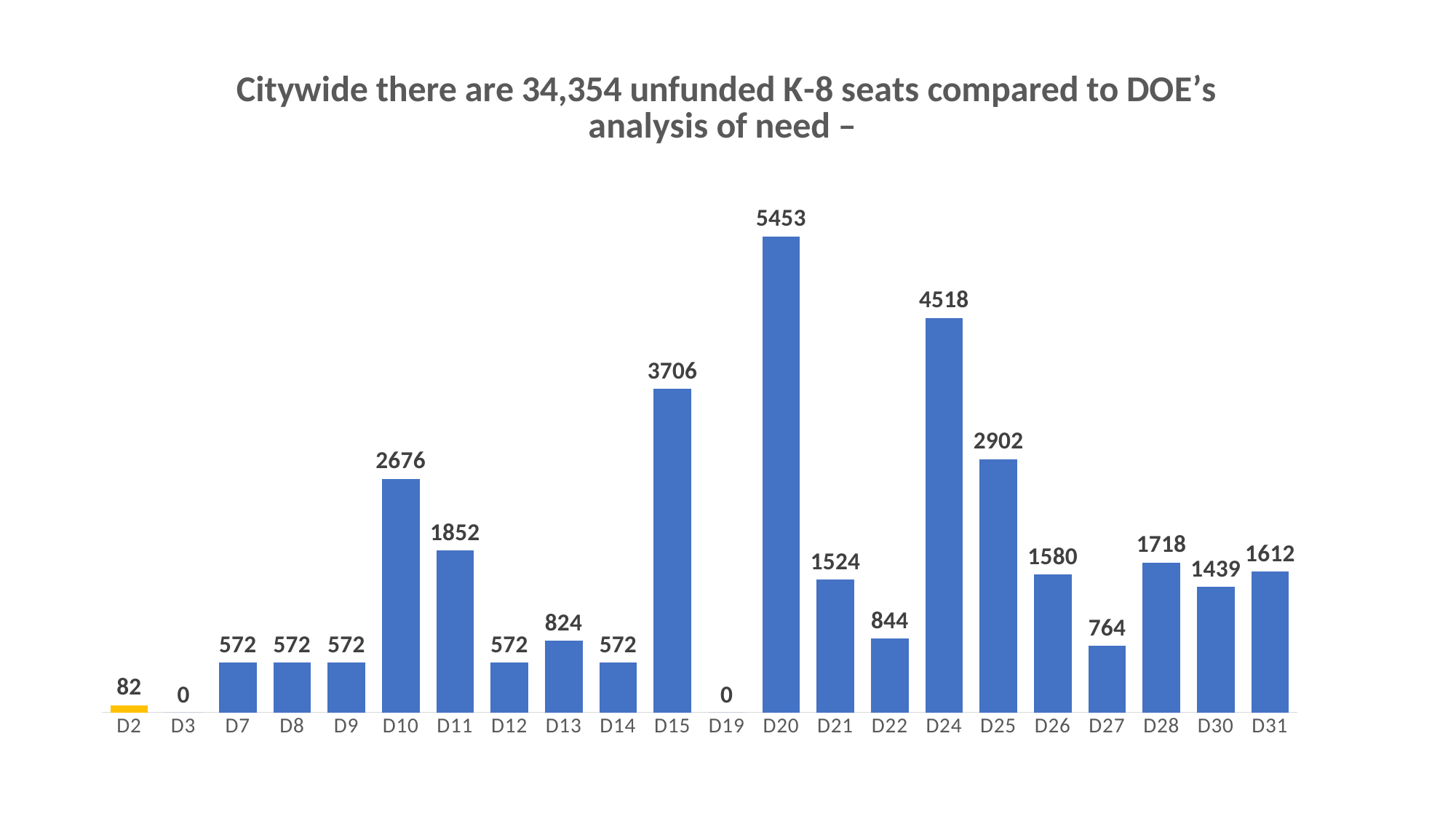
Which district's bar is coloured differently (yellow) from the others? D2 What is the difference between the values for D15 and D10? 1030 Which district has the highest value? D20 How many districts are shown on the x axis? 22 What is the value for D27? 764 What is the value for D20? 5453 Which is larger, the value for D25 or the value for D11? D25 What is the value for D2? 82 What is the lowest value shown on the chart? 0 What is the difference between the values for D20 and D24? 935 What kind of chart is shown on the slide? Bar chart What is the value for D15? 3706